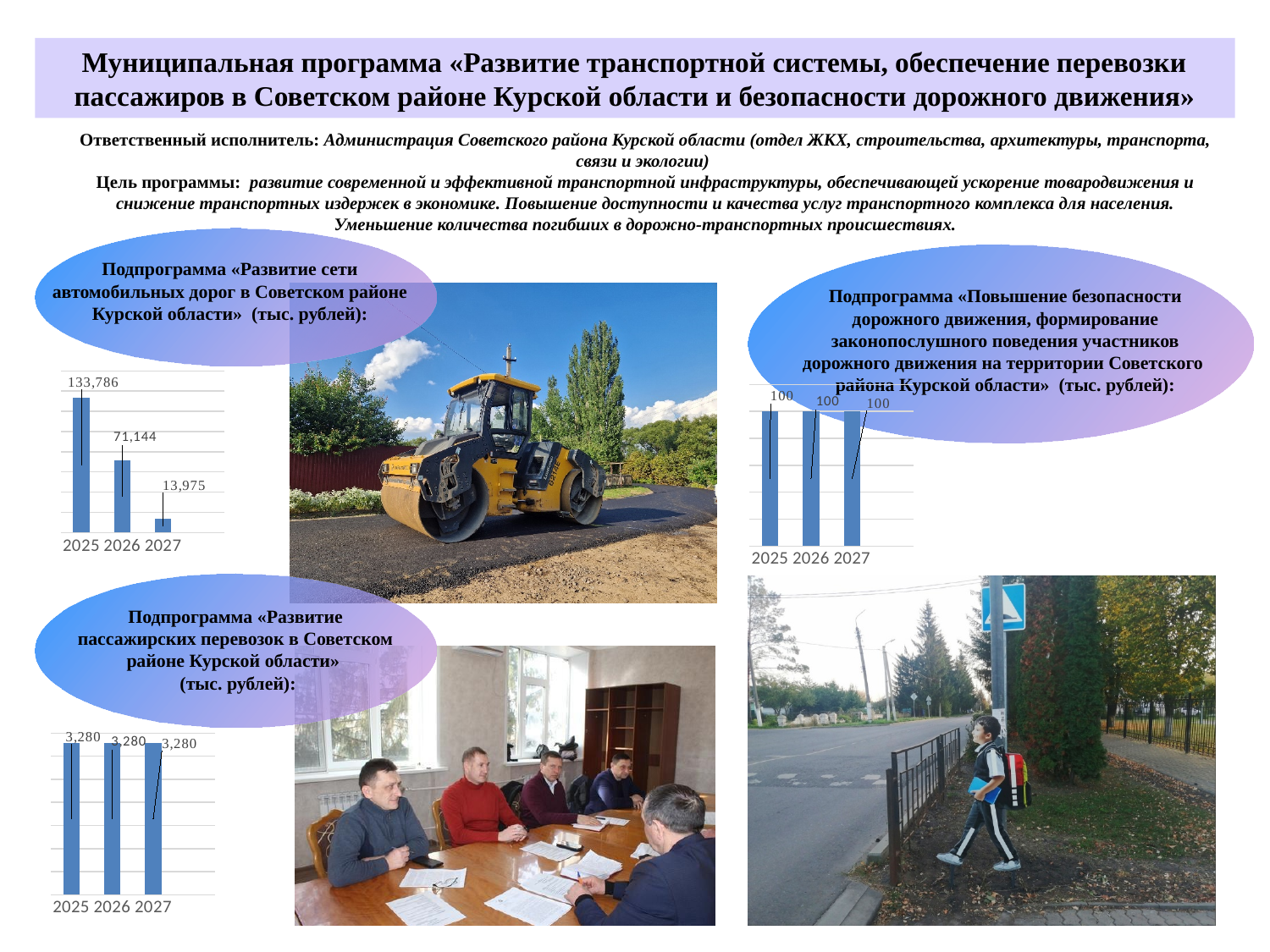
On the top-left chart (road network subprogram), what is the value for 2025? 133,786 On the bottom-left chart (passenger transport subprogram), do the values change from 2025 to 2027? No, they stay the same On the bottom-left chart (passenger transport subprogram), what is the value for 2027? 3,280 On the top-left chart (road network subprogram), which year has the highest value? 2025 What type of chart is the top-left chart (road network subprogram)? bar chart On the top-left chart (road network subprogram), what is the value for 2027? 13,975 On the top-left chart (road network subprogram), do the values rise or fall from 2025 to 2027? fall On the top-left chart (road network subprogram), which year has the lowest value? 2027 On the top-left chart (road network subprogram), what is the value for 2026? 71,144 On the top-left chart (road network subprogram), what is the difference between the 2025 and 2026 values? 62,642 How many years are shown on the bottom-left chart (passenger transport subprogram)? 3 On the top-right chart (road safety subprogram), what is the value for 2026? 100